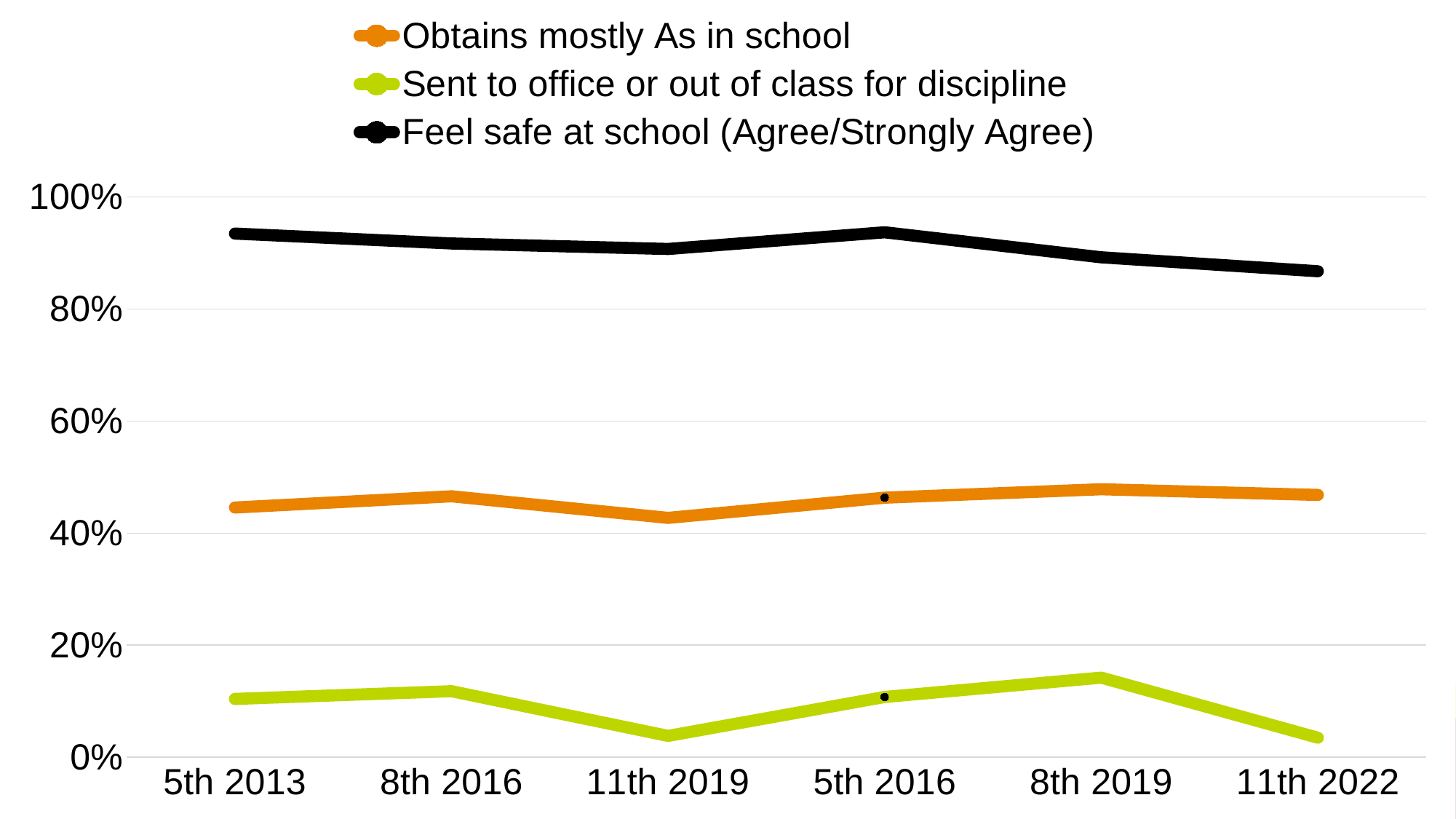
What colour is the line for 'Feel safe at school (Agree/Strongly Agree)'? black Does the 'Feel safe at school (Agree/Strongly Agree)' series rise or fall from 5th 2016 to 11th 2022? fall Is the value for 'Obtains mostly As in school' at 11th 2019 greater or less than 40%? greater Is the value for 'Feel safe at school (Agree/Strongly Agree)' at 11th 2022 greater or less than 80%? greater What kind of chart is shown on the slide? line chart Which category has the lowest value for the 'Feel safe at school (Agree/Strongly Agree)' series? 11th 2022 Which category has the highest value for the 'Sent to office or out of class for discipline' series? 8th 2019 How many series does the legend list? 3 Which category has the lowest value for the 'Obtains mostly As in school' series? 11th 2019 At 5th 2016, which series has the larger value: 'Feel safe at school (Agree/Strongly Agree)' or 'Obtains mostly As in school'? Feel safe at school (Agree/Strongly Agree) Is the value for 'Sent to office or out of class for discipline' at 11th 2019 greater or less than 20%? less How many categories are shown along the x axis? 6